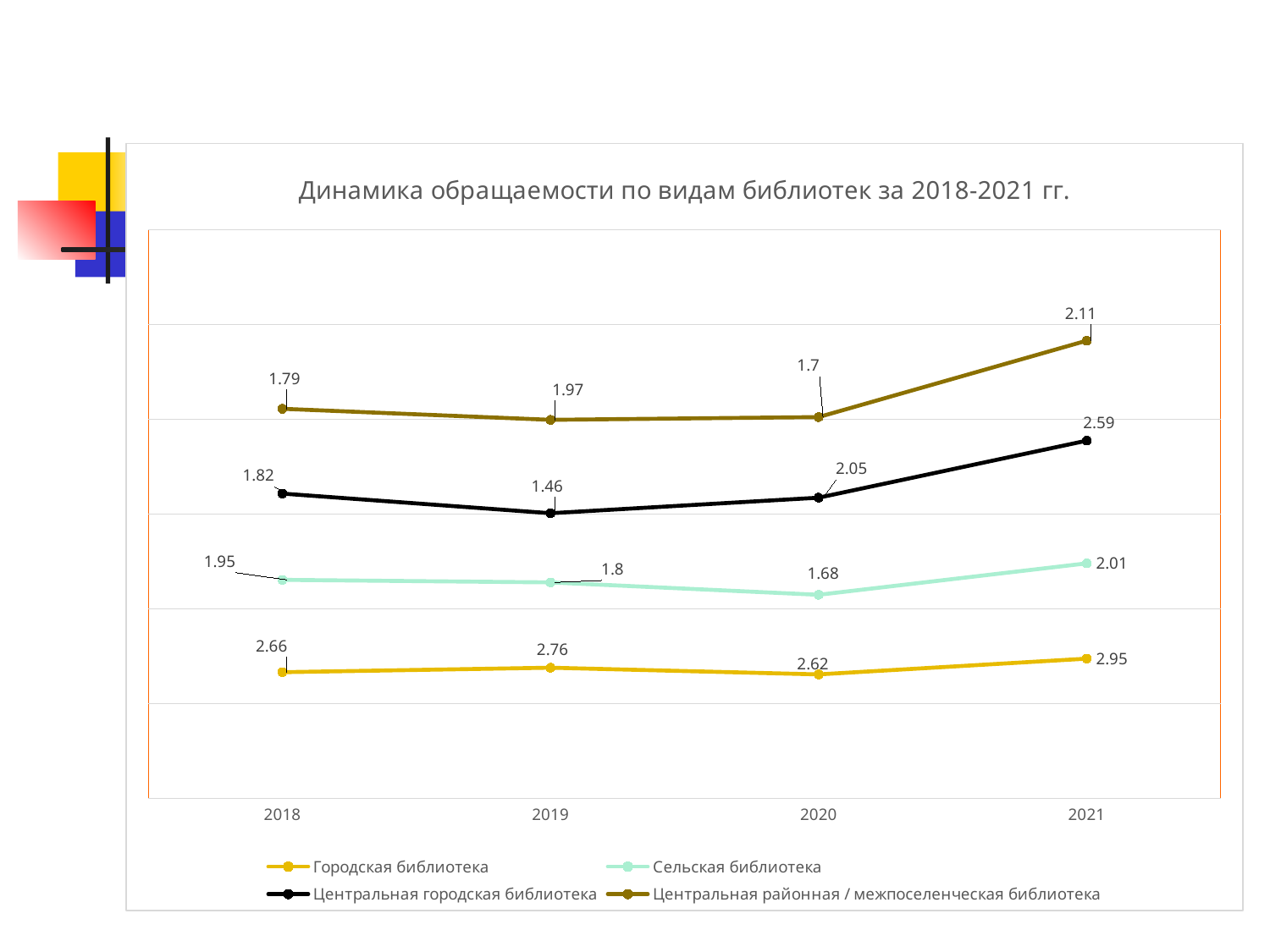
What is the value for Центральная городская библиотека in 2019? 1.46 How many years are shown on the x axis? 4 What is the value for Центральная районная / межпоселенческая библиотека in 2018? 1.79 In which year is the value for Центральная городская библиотека the lowest? 2019 Which is larger in 2019: the value for Сельская библиотека or the value for Центральная районная / межпоселенческая библиотека? Центральная районная / межпоселенческая библиотека What is the value for Сельская библиотека in 2020? 1.68 What kind of chart is this? line chart How many series does the legend list? 4 Does the value for Центральная городская библиотека rise or fall from 2019 to 2021? rise What is the value for Городская библиотека in 2021? 2.95 In which year is the value for Городская библиотека the highest? 2021 What is the difference between the 2021 and 2020 values for Центральная городская библиотека? 0.54